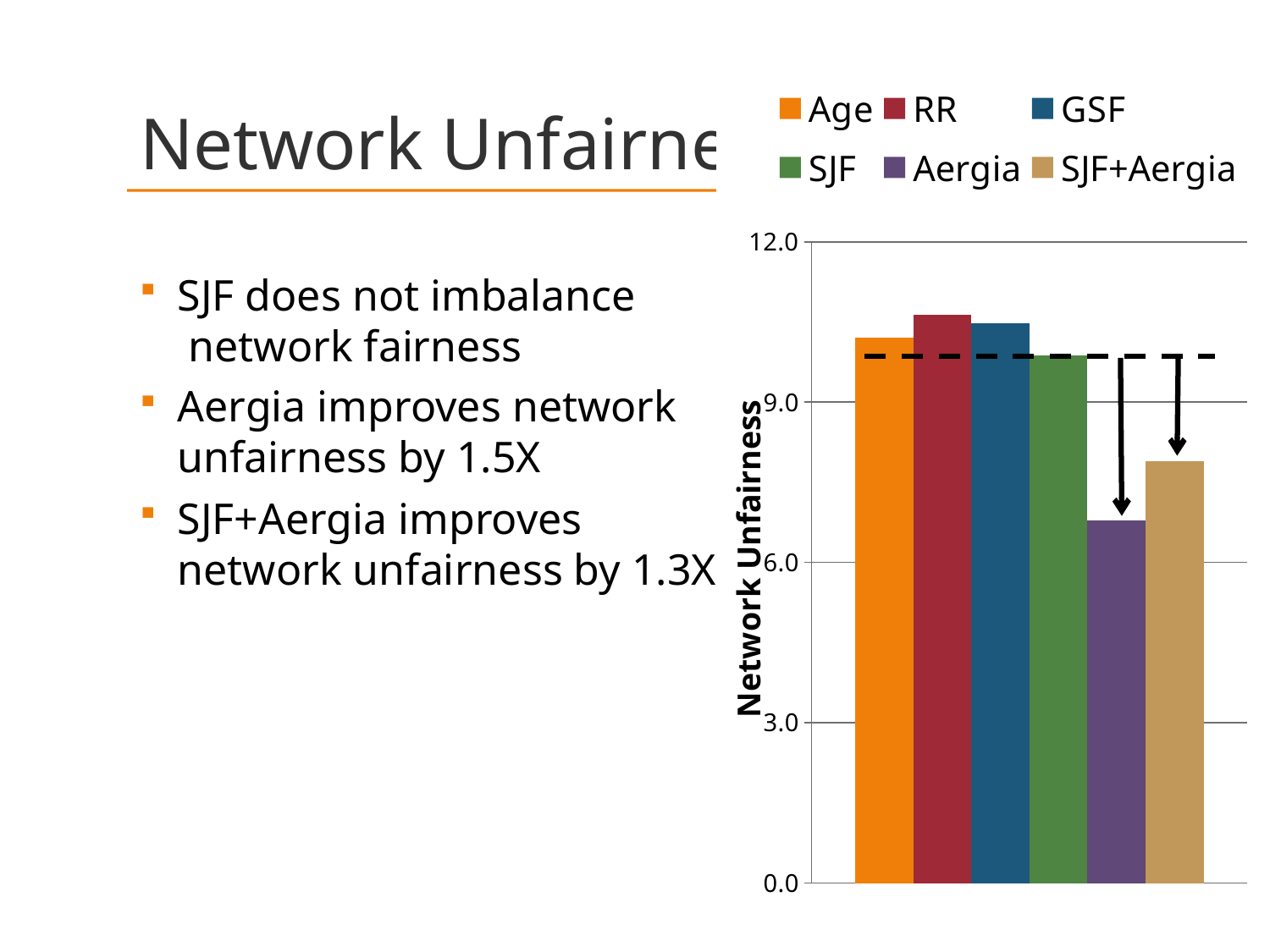
Is the Network Unfairness value for RR greater or less than 9.0? greater Which series has the lowest Network Unfairness value? Aergia Which has the larger Network Unfairness value, Aergia or SJF+Aergia? SJF+Aergia How many series does the chart's legend list? 6 Is the Network Unfairness value for SJF+Aergia greater or less than 9.0? less Is the Network Unfairness value for Aergia greater or less than 9.0? less What kind of chart is shown on the slide? bar chart Which series is shown in purple in the chart's legend? Aergia Which has the larger Network Unfairness value, Age or Aergia? Age Which has the larger Network Unfairness value, SJF or SJF+Aergia? SJF What is the title of the chart's vertical axis? Network Unfairness